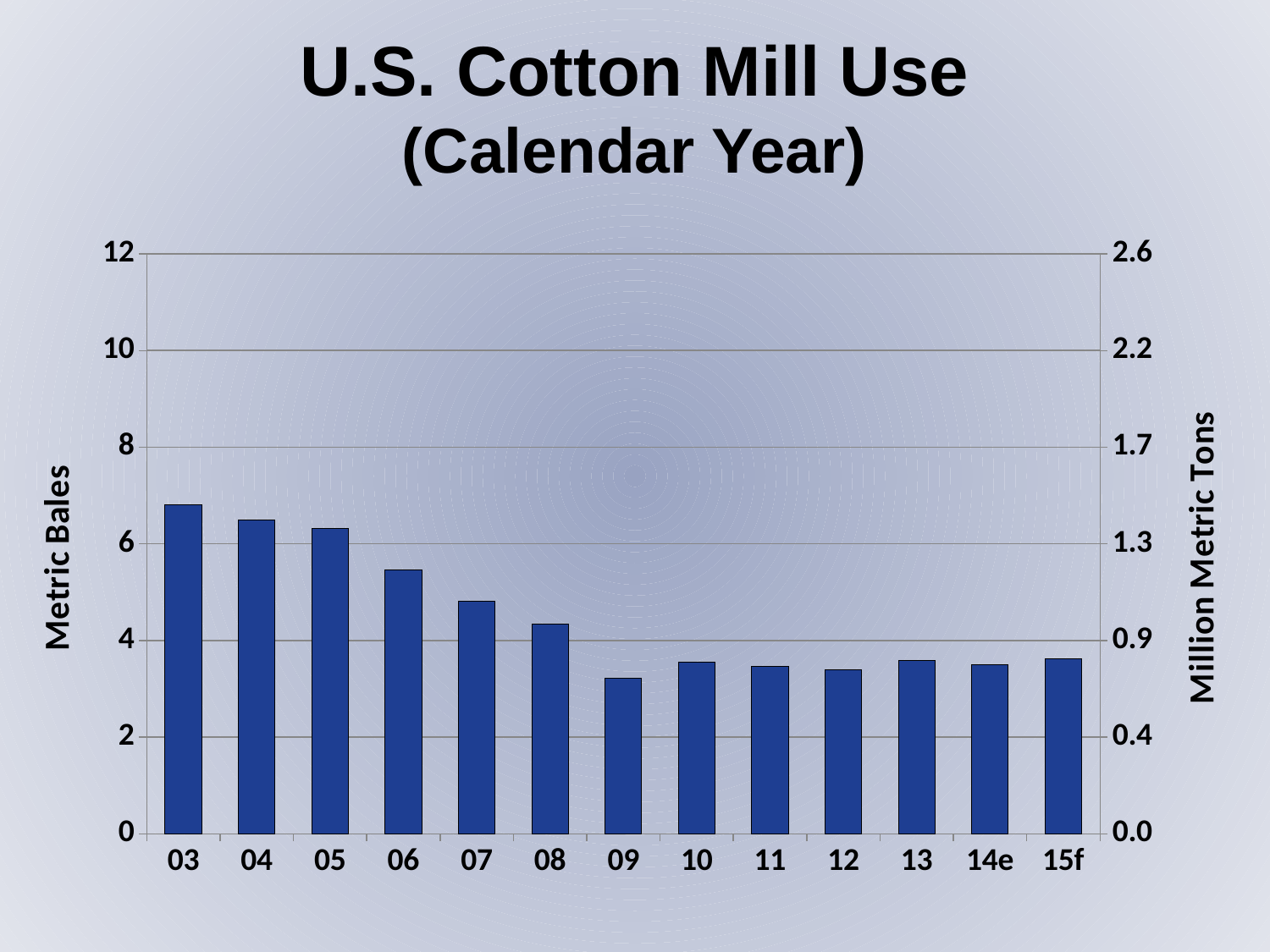
Is the value for 03 greater or less than 6 on the Metric Bales axis? greater Do the values rise or fall from 03 to 09? fall Is the value for 09 greater or less than 4 on the Metric Bales axis? less Is the value for 07 greater or less than 4 on the Metric Bales axis? greater How many years (categories) are plotted on the x axis? 13 What is the title of the chart? U.S. Cotton Mill Use (Calendar Year) What is the label on the right-hand vertical axis? Million Metric Tons Which year has the lowest cotton mill use? 09 What kind of chart is shown on the slide? bar chart Which is larger, the value for 06 or the value for 08? 06 Which year has the highest cotton mill use? 03